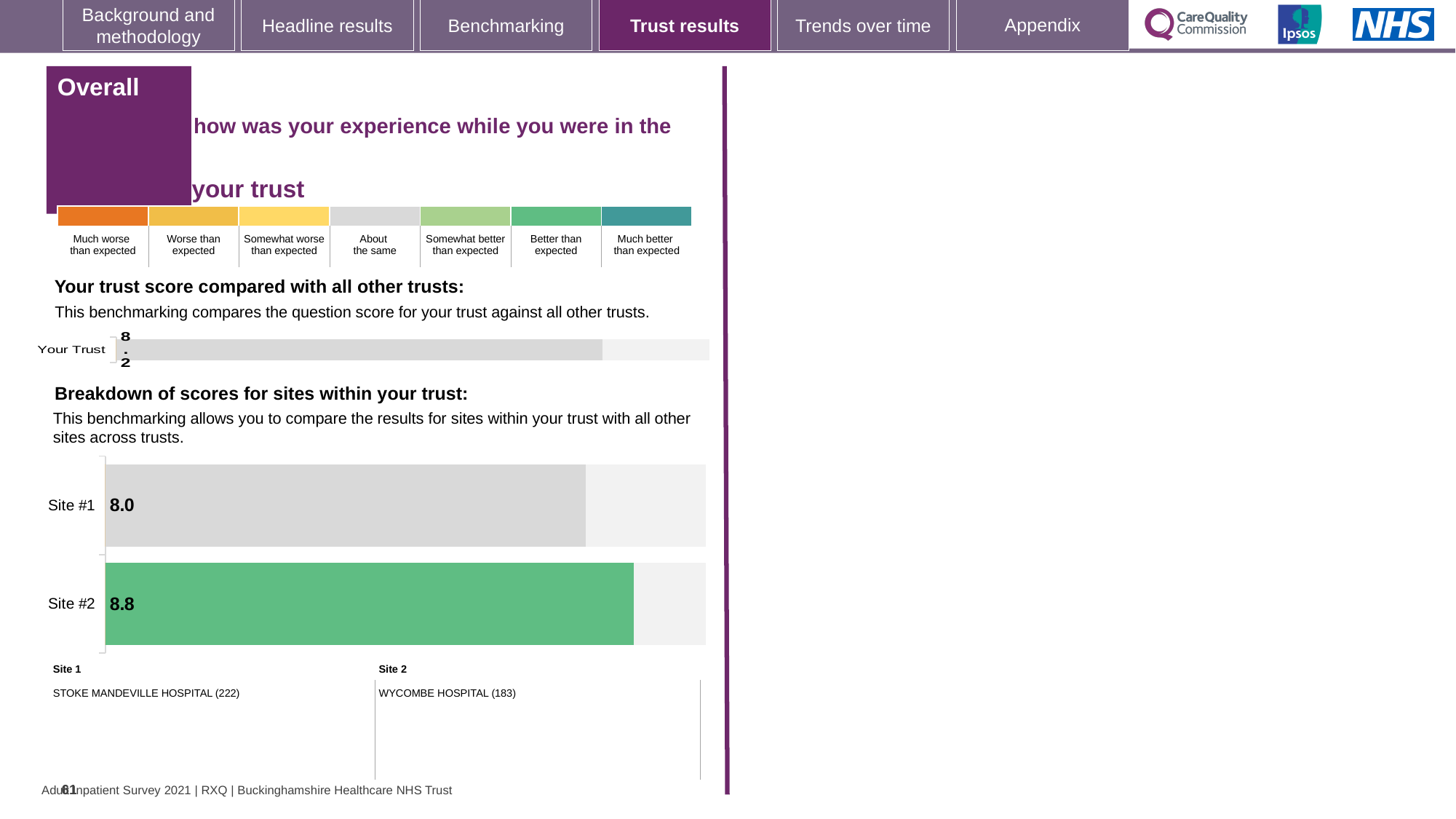
What kind of chart is used in the 'Breakdown of scores for sites within your trust' section? bar chart In the 'Breakdown of scores for sites within your trust' chart, which site has the higher score? Site #2 In the 'Breakdown of scores for sites within your trust' chart, what is the score for Site #2? 8.8 How many bars are shown in the 'Your trust score compared with all other trusts' chart? 1 How many sites are plotted in the 'Breakdown of scores for sites within your trust' chart? 2 In the 'Breakdown of scores for sites within your trust' chart, is the score for Site #1 larger or smaller than the score for Site #2? smaller According to the key below the chart, which hospital is Site 2? WYCOMBE HOSPITAL (183) In the 'Breakdown of scores for sites within your trust' chart, what is the difference between the scores of Site #2 and Site #1? 0.8 In the 'Breakdown of scores for sites within your trust' chart, what colour is the bar for Site #2? green In the 'Breakdown of scores for sites within your trust' chart, which site has the lower score? Site #1 In the 'Your trust score compared with all other trusts' chart, what is the score shown for Your Trust? 8.2 In the 'Breakdown of scores for sites within your trust' chart, what is the score for Site #1? 8.0